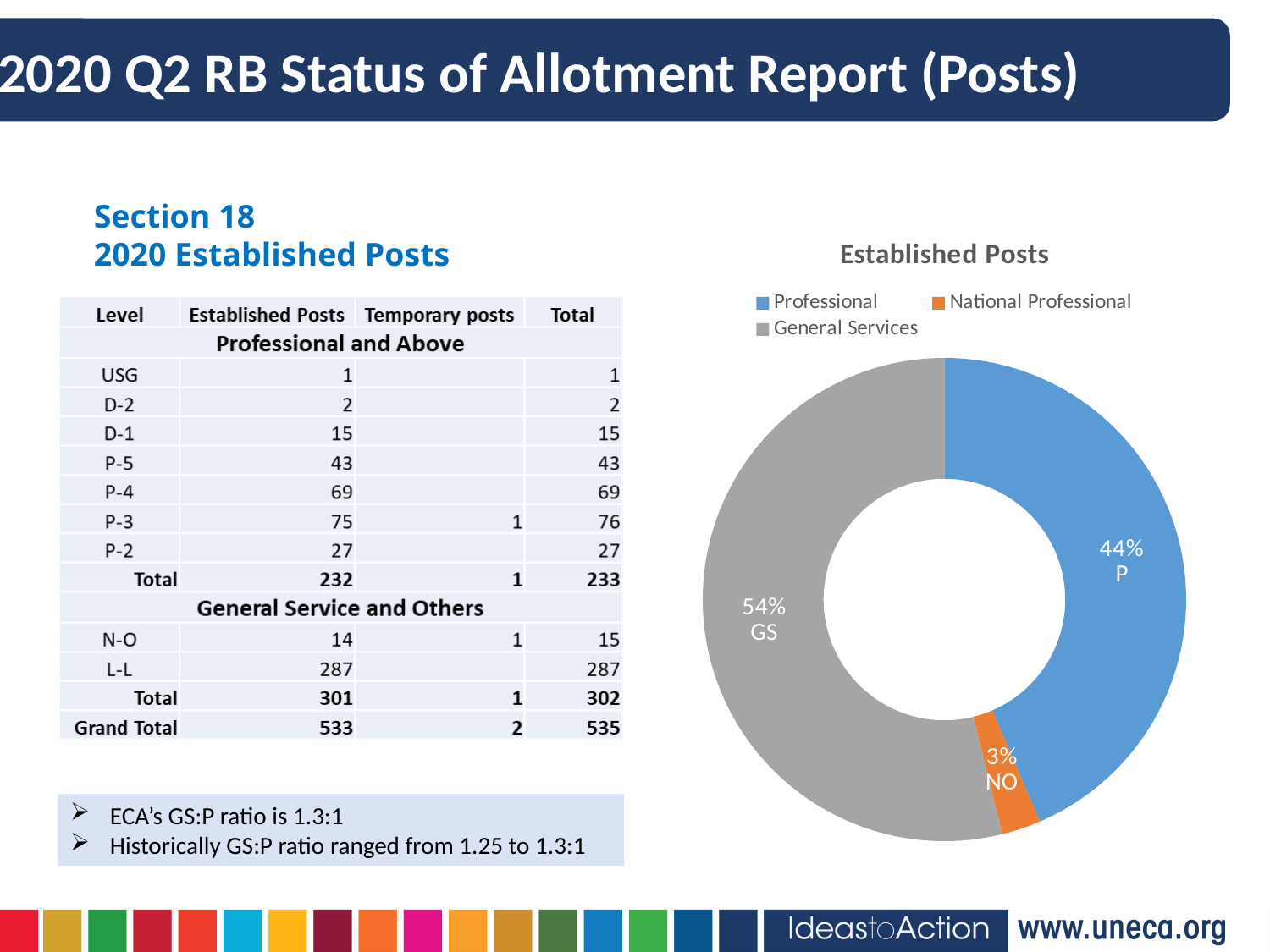
What share of the "Established Posts" chart is National Professional? 3% What is the title of the chart on the slide? Established Posts In the "Established Posts" chart, which is larger: the Professional share or the General Services share? General Services Which category has the largest share in the "Established Posts" chart? General Services What share of the "Established Posts" chart is General Services? 54% What share of the "Established Posts" chart is Professional? 44% How many entries does the legend of the "Established Posts" chart list? 3 What kind of chart is the "Established Posts" chart? doughnut chart Which category has the smallest share in the "Established Posts" chart? National Professional In the "Established Posts" chart, what is the difference between the General Services share and the Professional share? 10% How many slices does the "Established Posts" chart have? 3 Which colour represents National Professional in the "Established Posts" chart? orange